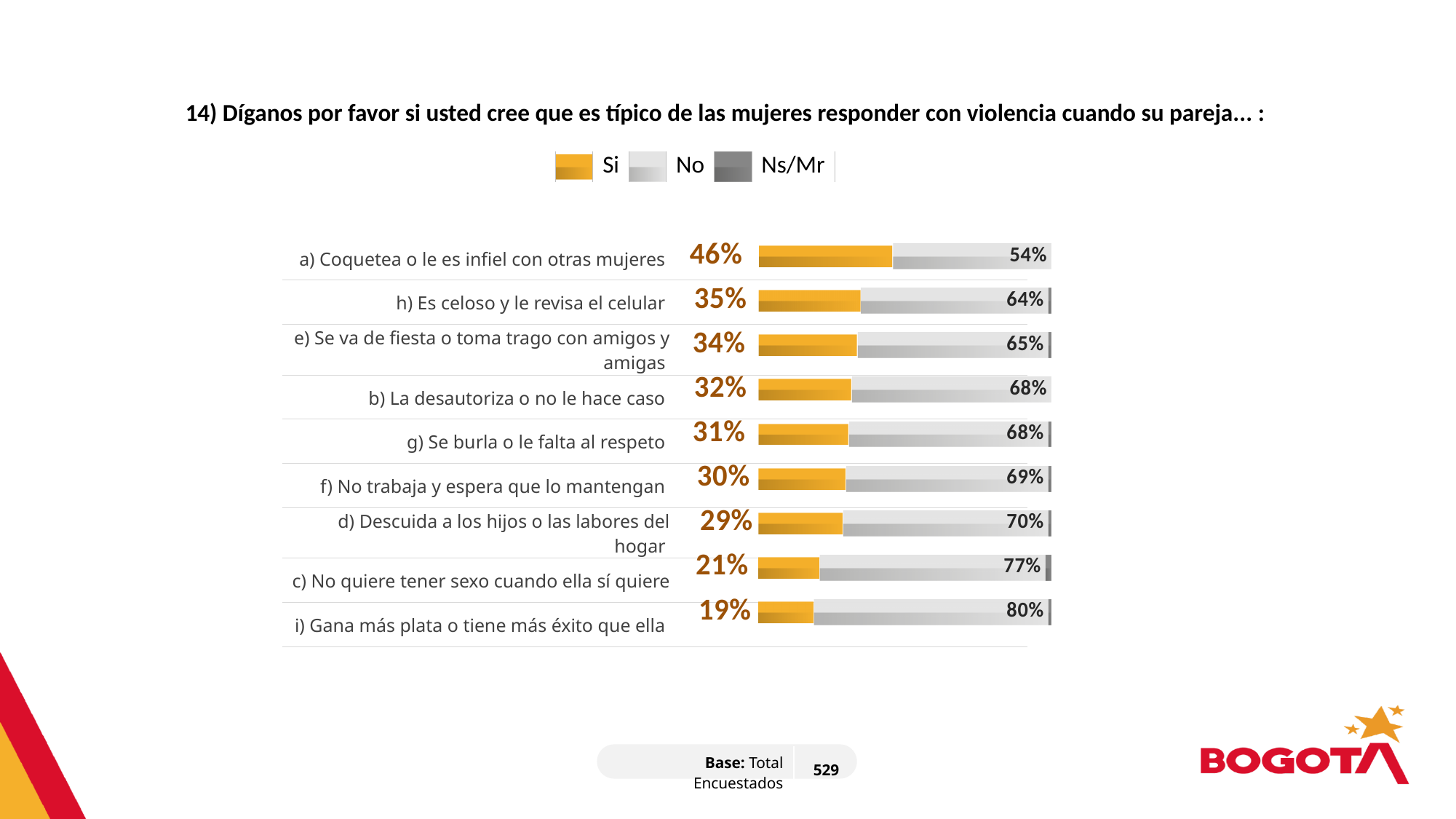
What is the "Si" value for "c) No quiere tener sexo cuando ella sí quiere"? 21% What percentage answered "No" for "i) Gana más plata o tiene más éxito que ella"? 80% Which category has the highest "Si" percentage? a) Coquetea o le es infiel con otras mujeres What is the difference between the "Si" values for "a) Coquetea o le es infiel con otras mujeres" and "h) Es celoso y le revisa el celular"? 11% What kind of chart is shown on the slide? Stacked bar chart How many categories are shown in the chart? 9 How many series does the legend list? 3 Which colour represents the "Si" series in the legend? Orange What percentage answered "Si" for "a) Coquetea o le es infiel con otras mujeres"? 46% Which has a larger "No" value: "c) No quiere tener sexo cuando ella sí quiere" or "d) Descuida a los hijos o las labores del hogar"? c) No quiere tener sexo cuando ella sí quiere Which category has the lowest "Si" percentage? i) Gana más plata o tiene más éxito que ella What is the "No" value for "h) Es celoso y le revisa el celular"? 64%